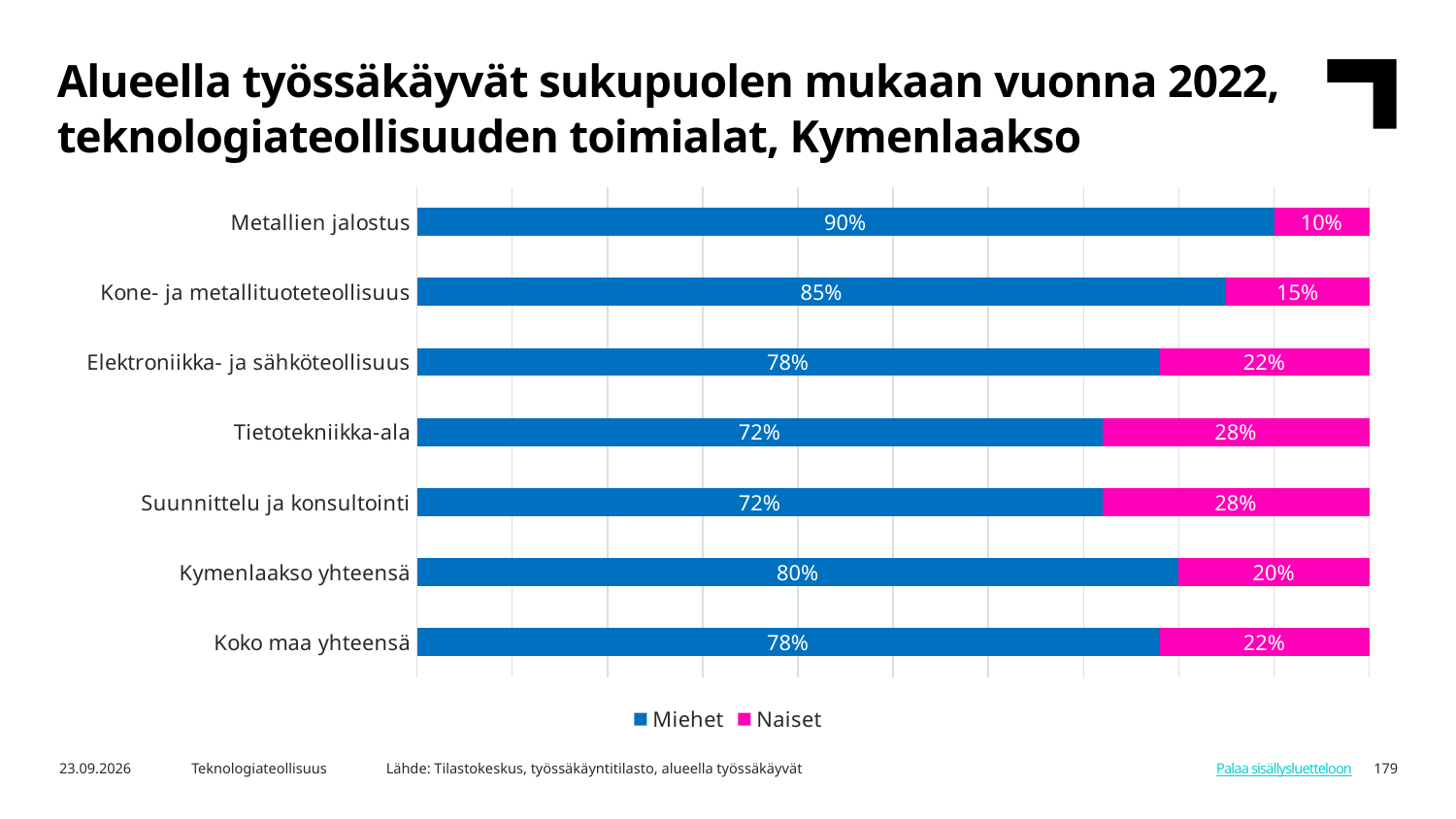
How many series does the legend list? 2 What is the difference between the Miehet share for Kone- ja metallituoteteollisuus and the Miehet share for Elektroniikka- ja sähköteollisuus? 7% What is the Miehet share for Metallien jalostus? 90% Which category has the highest Miehet share? Metallien jalostus Which is larger: the Naiset share for Kone- ja metallituoteteollisuus or the Naiset share for Suunnittelu ja konsultointi? Suunnittelu ja konsultointi What is the total of the stacked bar for Elektroniikka- ja sähköteollisuus? 100% What kind of chart is shown on the slide? Stacked bar chart What is the Miehet share for Koko maa yhteensä? 78% What is the Naiset share for Tietotekniikka-ala? 28% How many categories are shown on the chart? 7 What is the Naiset share for Kymenlaakso yhteensä? 20% Which category has the lowest Naiset share? Metallien jalostus